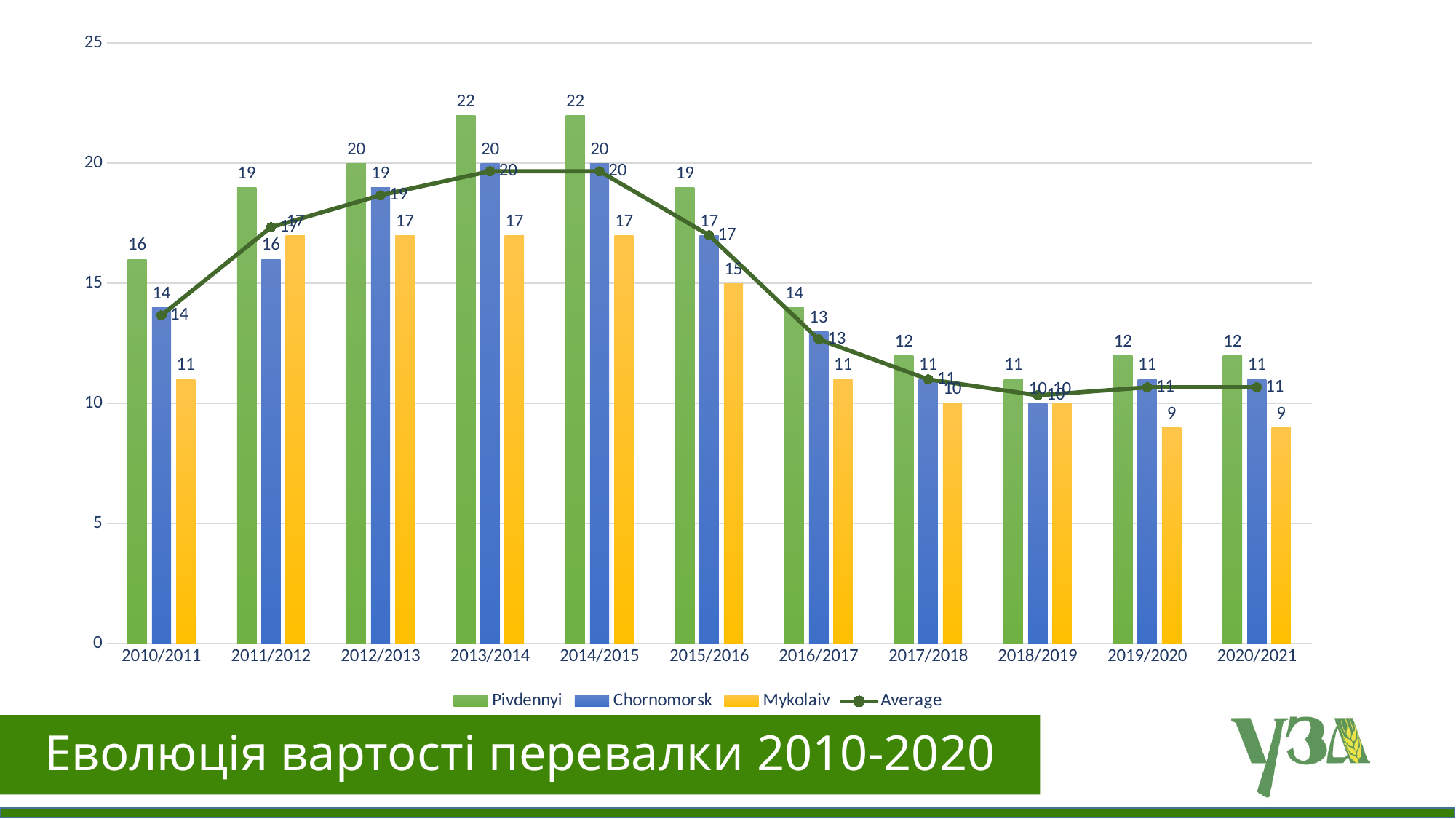
How many series does the legend list? 4 What is the value for Chornomorsk in 2016/2017? 13 What is the Average value in 2010/2011? 14 What kind of chart is this? Combined bar and line chart What is the value for Pivdennyi in 2013/2014? 22 What is the value for Mykolaiv in 2015/2016? 15 Which series is shown in yellow? Mykolaiv In which season is the Pivdennyi value lowest? 2018/2019 Which is larger in 2011/2012: the Chornomorsk value or the Mykolaiv value? Mykolaiv Does the Average line rise or fall from 2014/2015 to 2018/2019? Fall What is the difference between the Pivdennyi and Mykolaiv values in 2010/2011? 5 How many seasons are shown on the x axis? 11